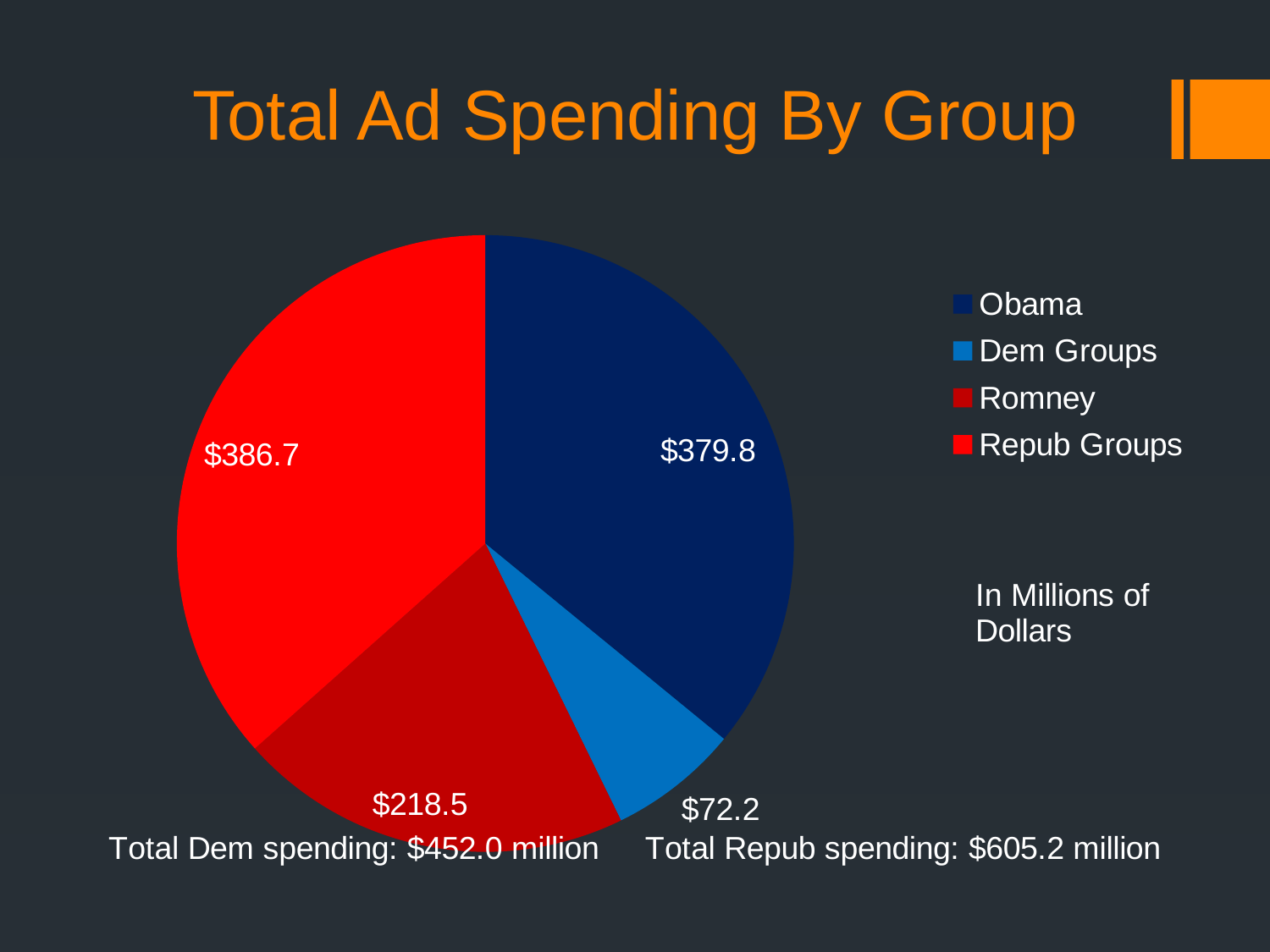
What is the value for Obama in the pie chart? $379.8 What is the value for Romney in the pie chart? $218.5 What is the difference between the Obama value and the Romney value? $161.3 What is the title of the chart on the slide? Total Ad Spending By Group What type of chart is shown on the slide? Pie chart What is the difference between the Romney value and the Dem Groups value? $146.3 What is the value for Repub Groups in the pie chart? $386.7 Which is larger, the Obama slice or the Romney slice? Obama How many slices does the pie chart have? 4 Which group has the largest slice of the pie chart? Repub Groups Which group has the smallest slice of the pie chart? Dem Groups What is the value for Dem Groups in the pie chart? $72.2